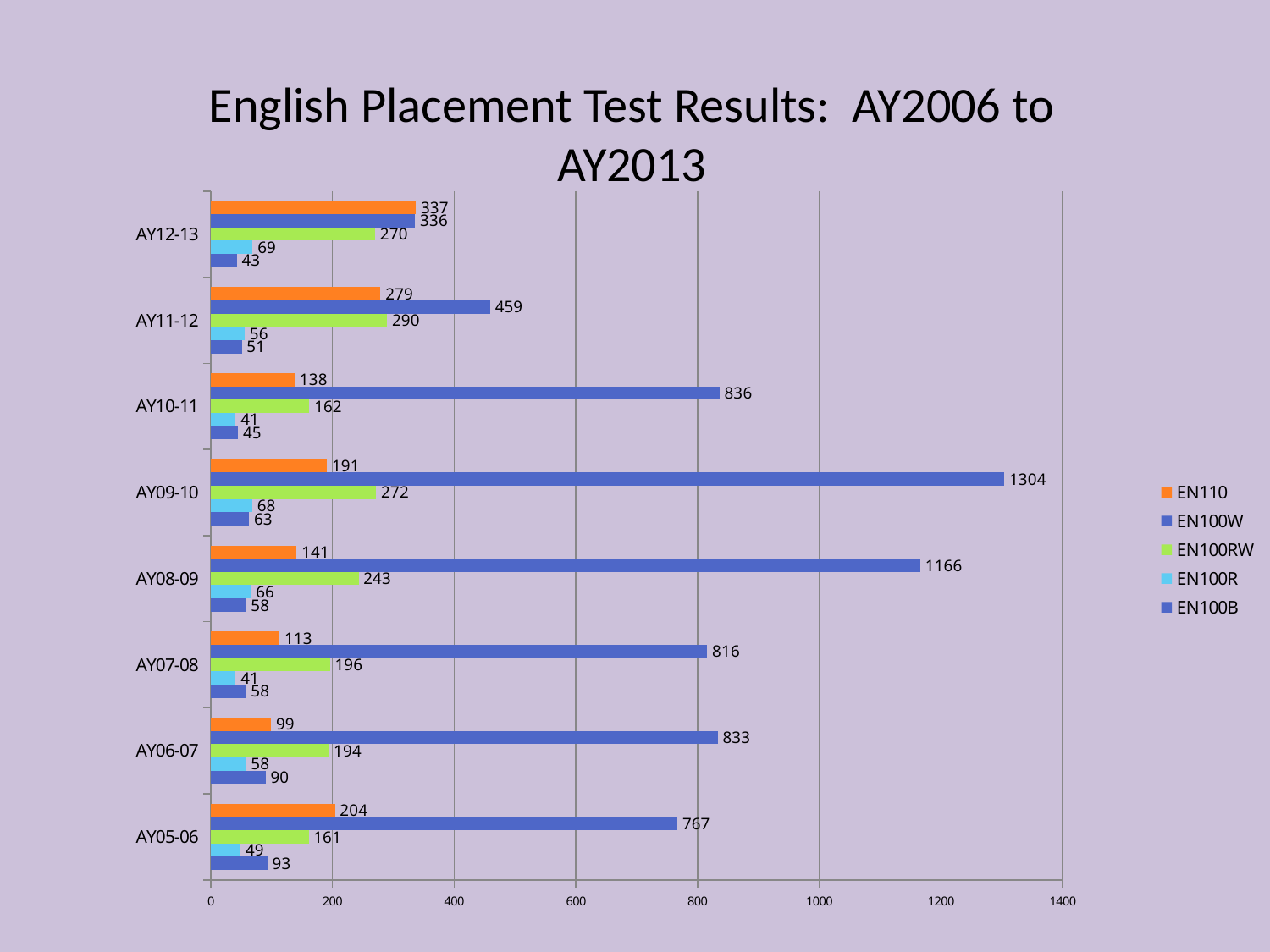
What is the EN100W value for AY09-10? 1304 What kind of chart is shown on the slide? Bar chart What is the EN100RW value for AY08-09? 243 What is the difference between the EN100W values for AY09-10 and AY08-09? 138 Which academic year has the lowest EN110 value? AY06-07 How many series does the legend list? 5 What is the EN110 value for AY12-13? 337 Which is larger, the EN100W value for AY11-12 or the EN100W value for AY10-11? AY10-11 How many academic years are shown on the chart? 8 What is the title of the chart? English Placement Test Results: AY2006 to AY2013 What is the EN100B value for AY05-06? 93 Which academic year has the highest EN100W value? AY09-10